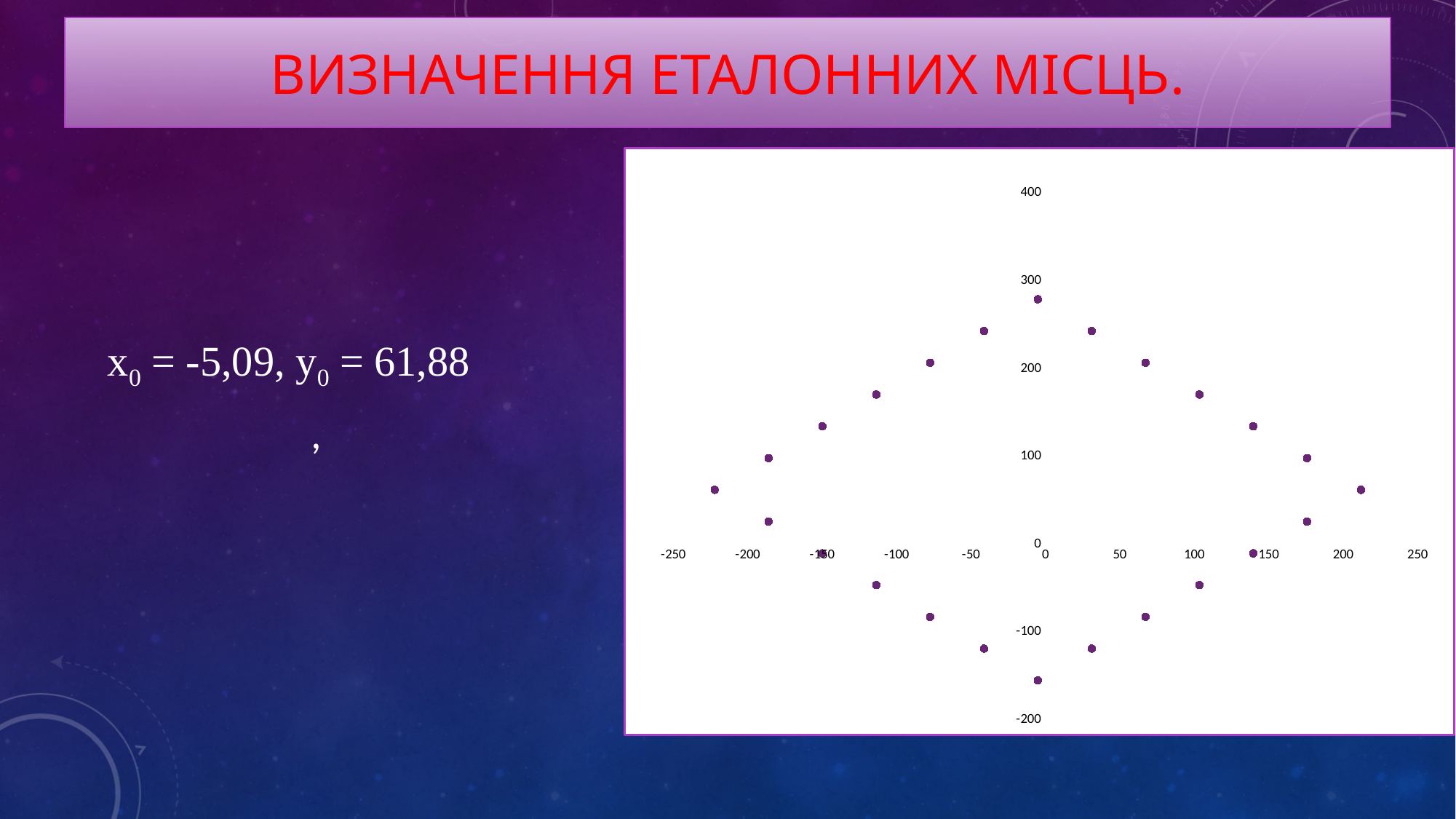
Is the y value of the lowest point on the chart greater or less than -100? less Is the y value of the highest point on the chart greater or less than 200? greater What is the lowest value shown on the horizontal axis of the chart? -250 What is the highest value shown on the vertical axis of the chart? 400 Is the x value of the leftmost point on the chart greater or less than -200? less What kind of chart is shown on the slide? scatter chart How many data points are plotted on the scatter chart? 24